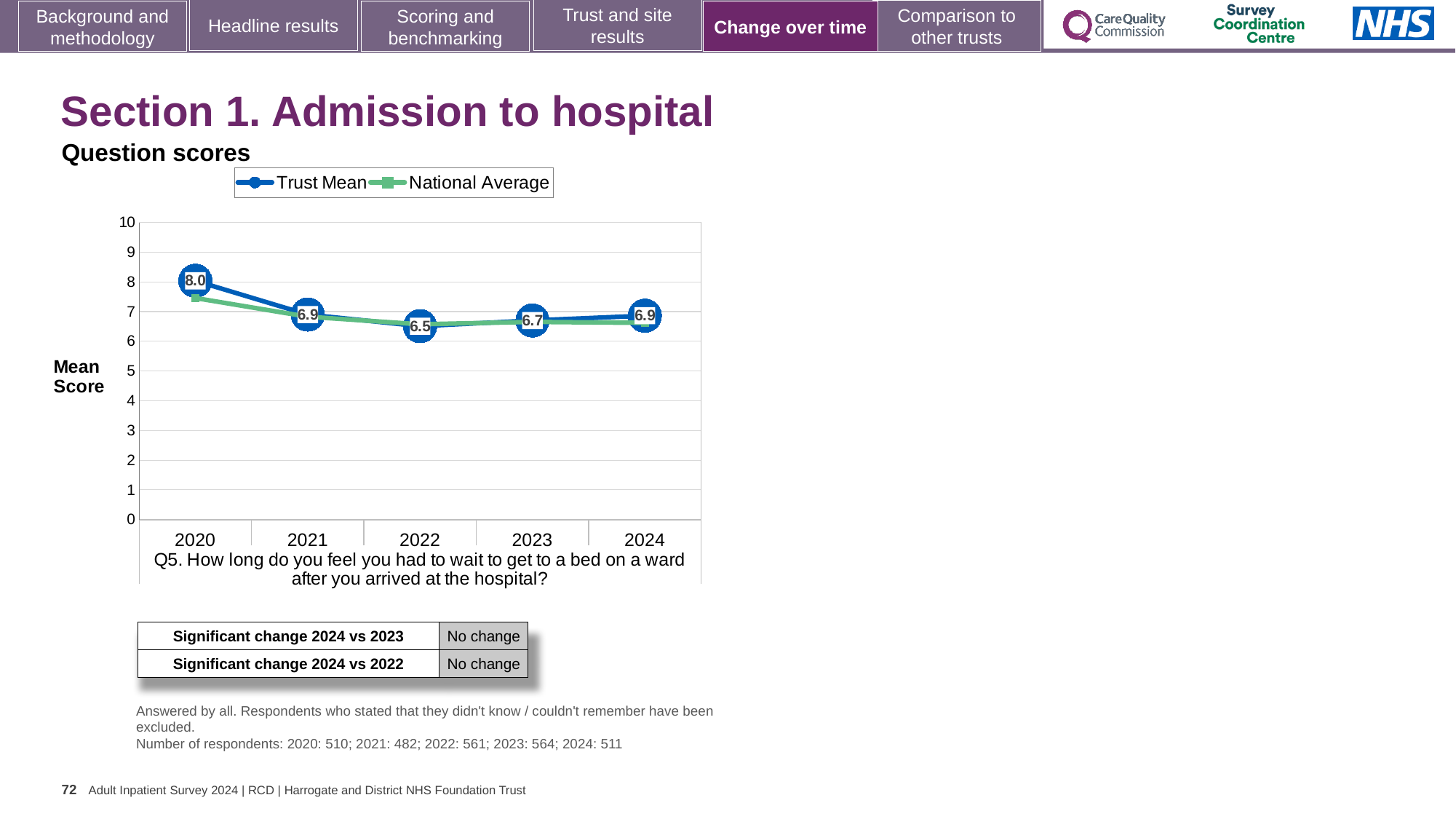
Which is larger, the Trust Mean score for 2021 or for 2022? 2021 Does the Trust Mean score rise or fall from 2020 to 2022? Fall What is the Trust Mean score for 2020? 8.0 How many years are plotted on the x axis? 5 What is the difference between the Trust Mean score in 2020 and in 2024? 1.1 In which year is the Trust Mean score lowest? 2022 How many series does the legend list? 2 What is the Trust Mean score for 2024? 6.9 Is the National Average value for 2020 greater or less than 7? greater What is the Trust Mean score for 2022? 6.5 In which year is the Trust Mean score highest? 2020 What kind of chart is shown on the slide? Line chart